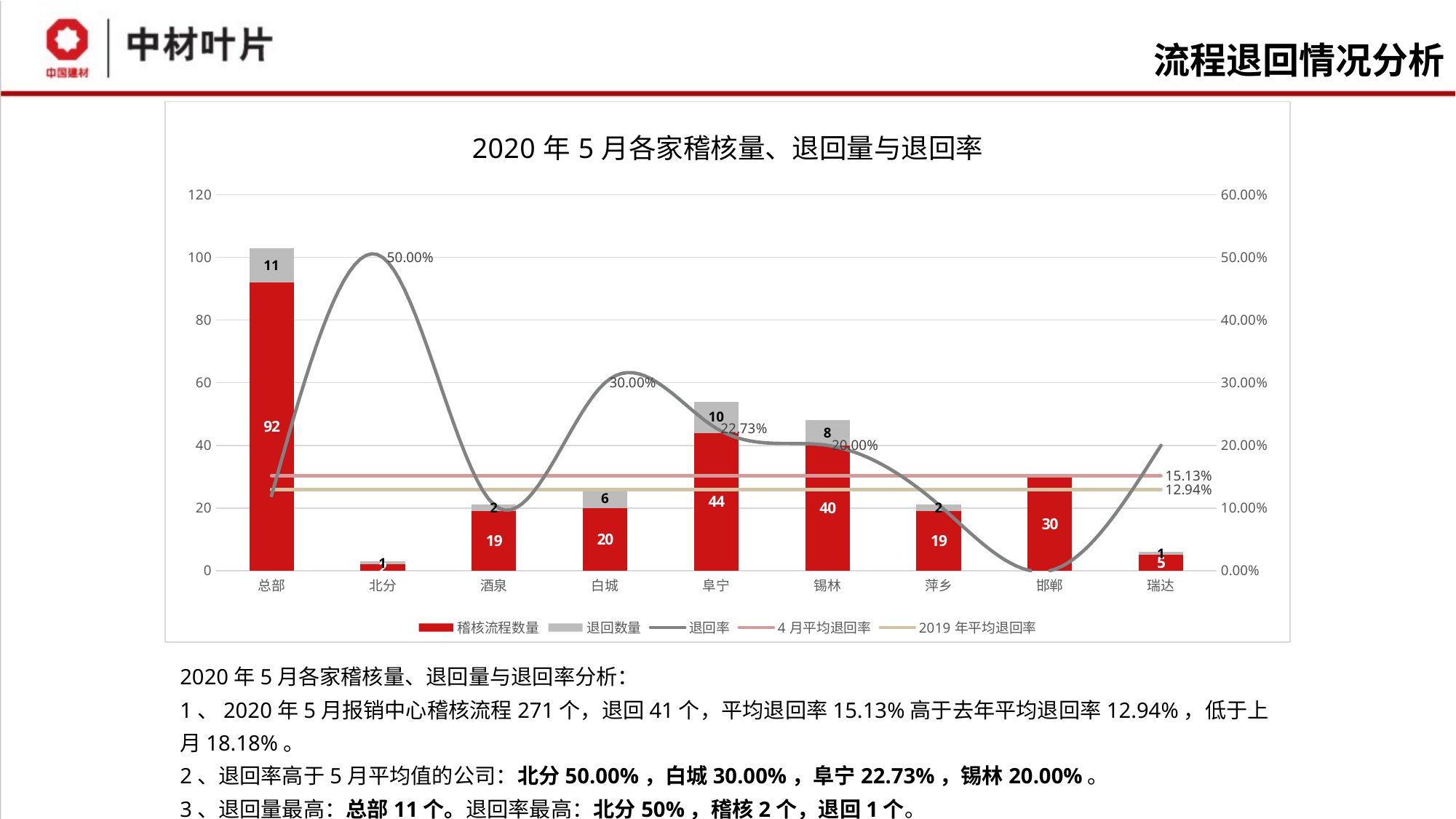
Which category has the lowest 稽核流程数量? 北分 Is the 稽核流程数量 for 邯郸 greater or less than 20? greater What is the 退回数量 value for 阜宁? 10 What is the difference between the 稽核流程数量 of 阜宁 and 锡林? 4 Which has a larger 退回数量, 白城 or 酒泉? 白城 What is the 稽核流程数量 value for 总部? 92 Which category has the highest 稽核流程数量? 总部 What is the total of the stacked bar for 总部 (稽核流程数量 plus 退回数量)? 103 How many series does the legend list? 5 What 退回率 is labelled for 北分? 50.00% How many categories are shown on the x axis? 9 What value is labelled on the 2019 年平均退回率 line? 12.94%